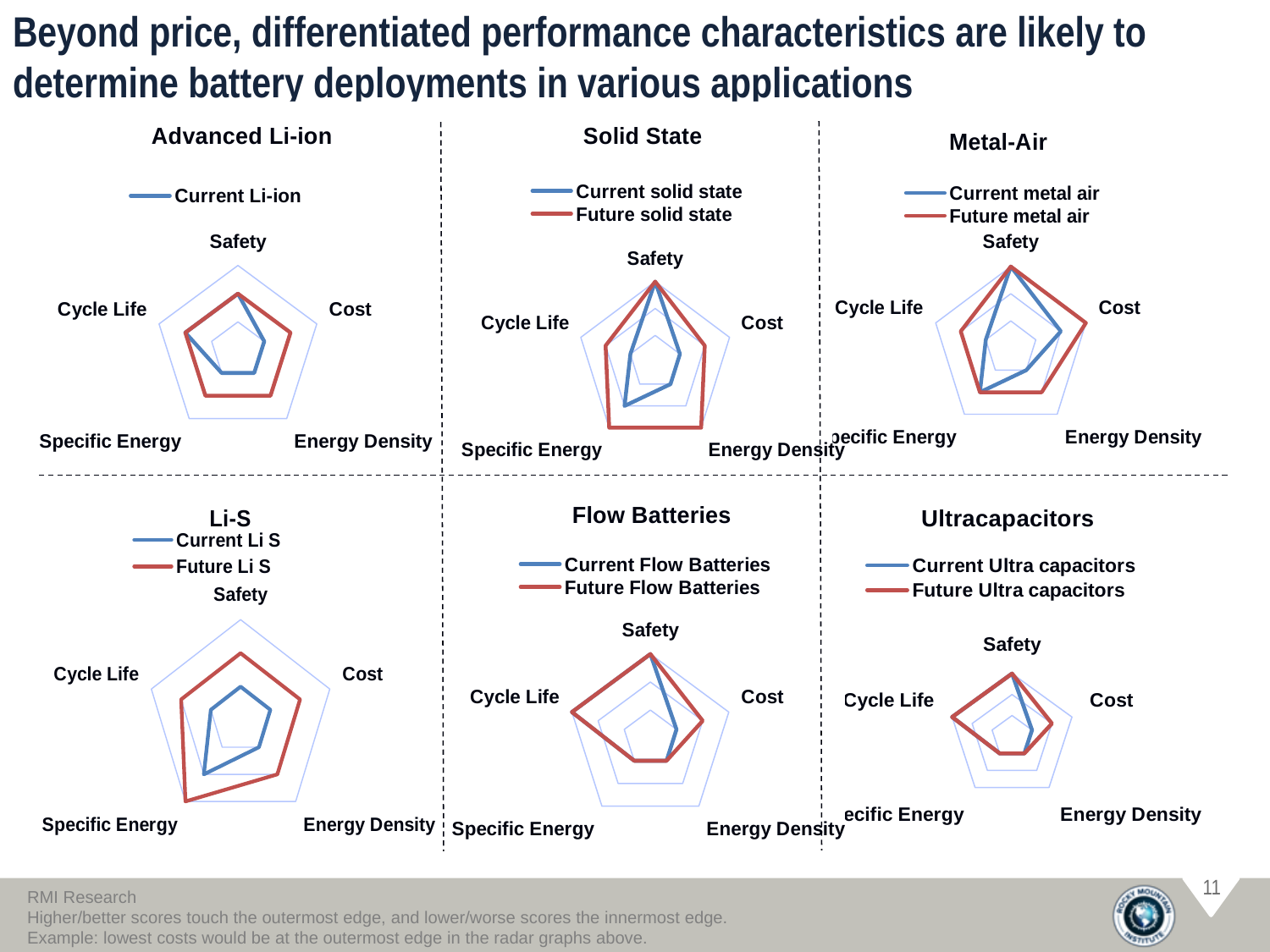
How many series does the legend of the Flow Batteries chart list? 2 In the Solid State chart, which series has the higher Energy Density score, Current solid state or Future solid state? Future solid state In the Metal-Air chart, on which axis does the Current metal air series have its highest score? Safety How many series does the legend of the Advanced Li-ion chart list? 1 How many performance axes does the Metal-Air radar chart have? 5 What kind of chart is the Solid State chart? Radar chart What are the two legend entries of the Li-S chart? Current Li S and Future Li S In the Li-S chart, on which axis does the Future Li S series reach its highest score? Specific Energy